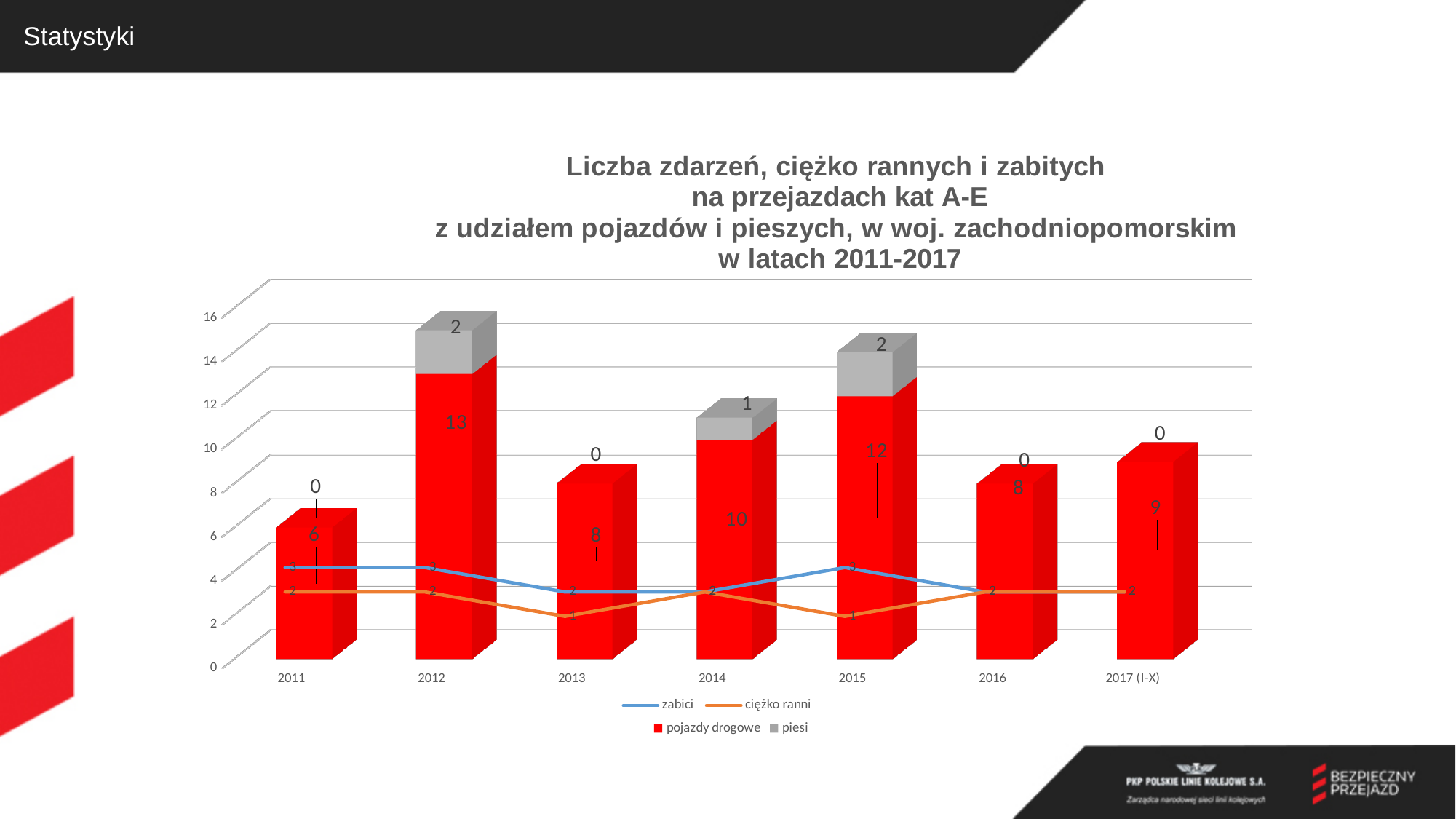
What is the total of the stacked bar for 2012 (pojazdy drogowe plus piesi)? 15 What is the value of piesi for 2015? 2 How many series does the legend list? 4 Which year has the highest value for pojazdy drogowe? 2012 Which year has the lowest value for pojazdy drogowe? 2011 What is the difference between the pojazdy drogowe values for 2012 and 2011? 7 How many years are shown on the x axis? 7 What is the value of pojazdy drogowe for 2017 (I-X)? 9 What colour represents piesi in the legend? grey What kind of chart is shown on the slide? bar and line chart What is the value of pojazdy drogowe for 2012? 13 Which year has a larger pojazdy drogowe value, 2014 or 2015? 2015